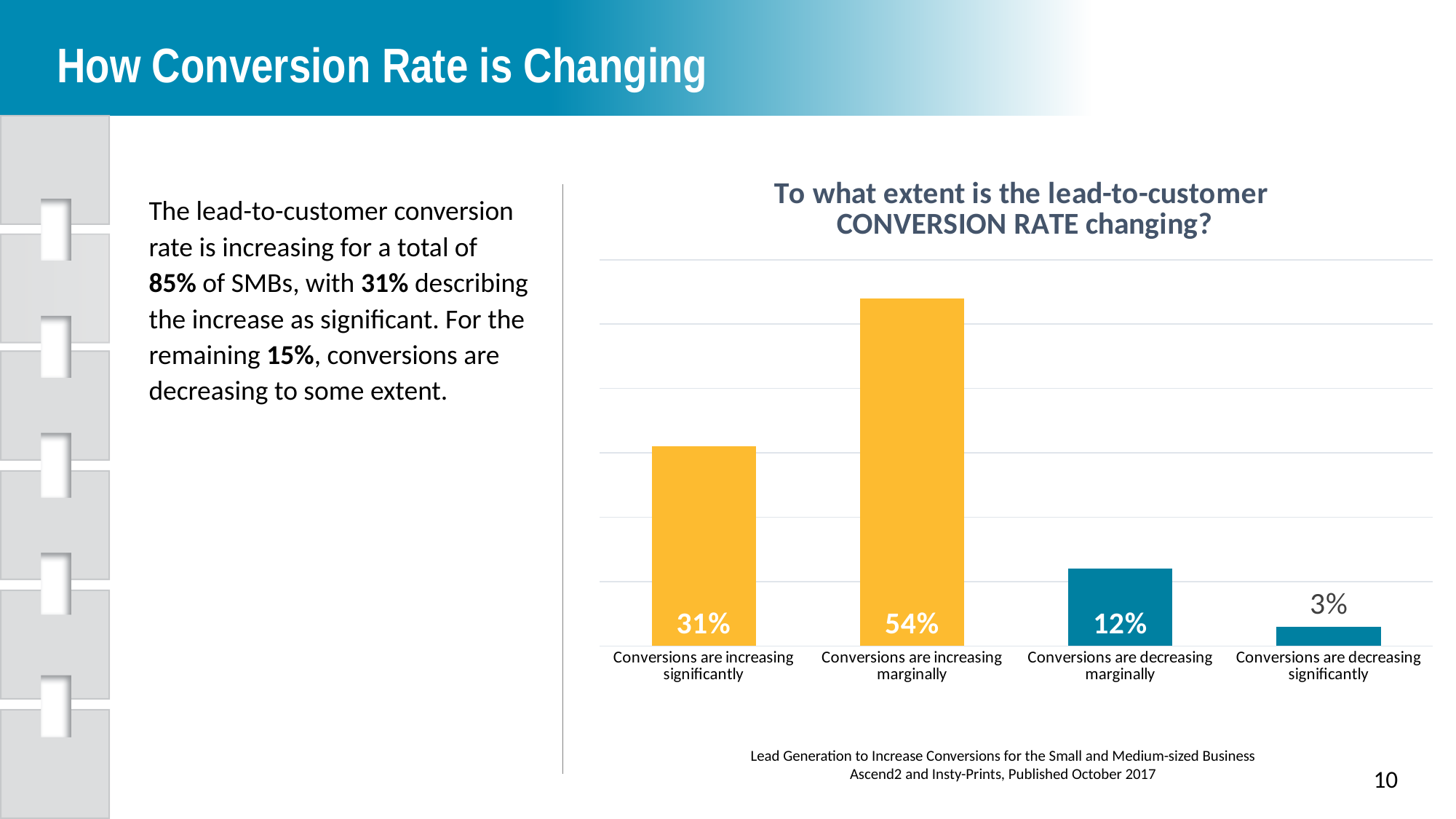
What is the title of the chart? To what extent is the lead-to-customer CONVERSION RATE changing? Which is larger: the value for 'Conversions are decreasing marginally' or 'Conversions are decreasing significantly'? Conversions are decreasing marginally What percentage of respondents say conversions are decreasing significantly? 3% What percentage of respondents say conversions are increasing significantly? 31% What colour are the bars for the two 'decreasing' categories? Blue What is the difference between the values for 'Conversions are increasing marginally' and 'Conversions are increasing significantly'? 23% What type of chart is shown on the slide? Bar chart Which category has the highest value? Conversions are increasing marginally What percentage of respondents say conversions are increasing marginally? 54% What percentage of respondents say conversions are decreasing marginally? 12% How many categories are shown in the chart? 4 Which category has the lowest value? Conversions are decreasing significantly